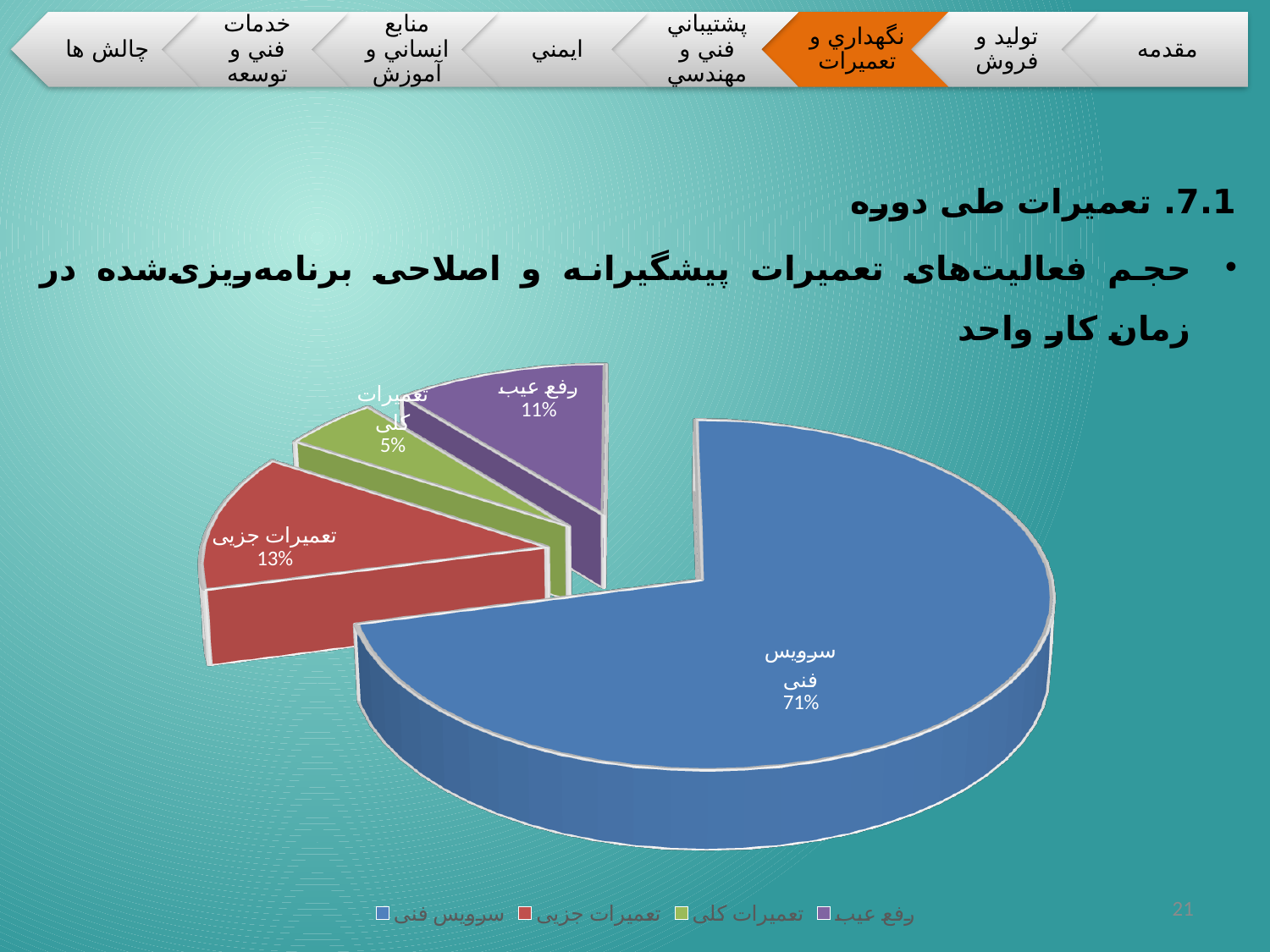
What share of the pie does رفع عیب have? 11% Which slice of the pie is the largest? سرویس فنی What share of the pie does سرویس فنی have? 71% How many slices does the pie chart have? 4 How many entries does the legend list? 4 What colour is the سرویس فنی slice in the pie chart? blue Which slice of the pie is the smallest? تعمیرات کلی Which is larger, the share for تعمیرات جزیی or the share for رفع عیب? تعمیرات جزیی What share of the pie does تعمیرات کلی have? 5% What kind of chart is shown on the slide? pie chart What is the difference in percentage points between سرویس فنی and تعمیرات جزیی? 58